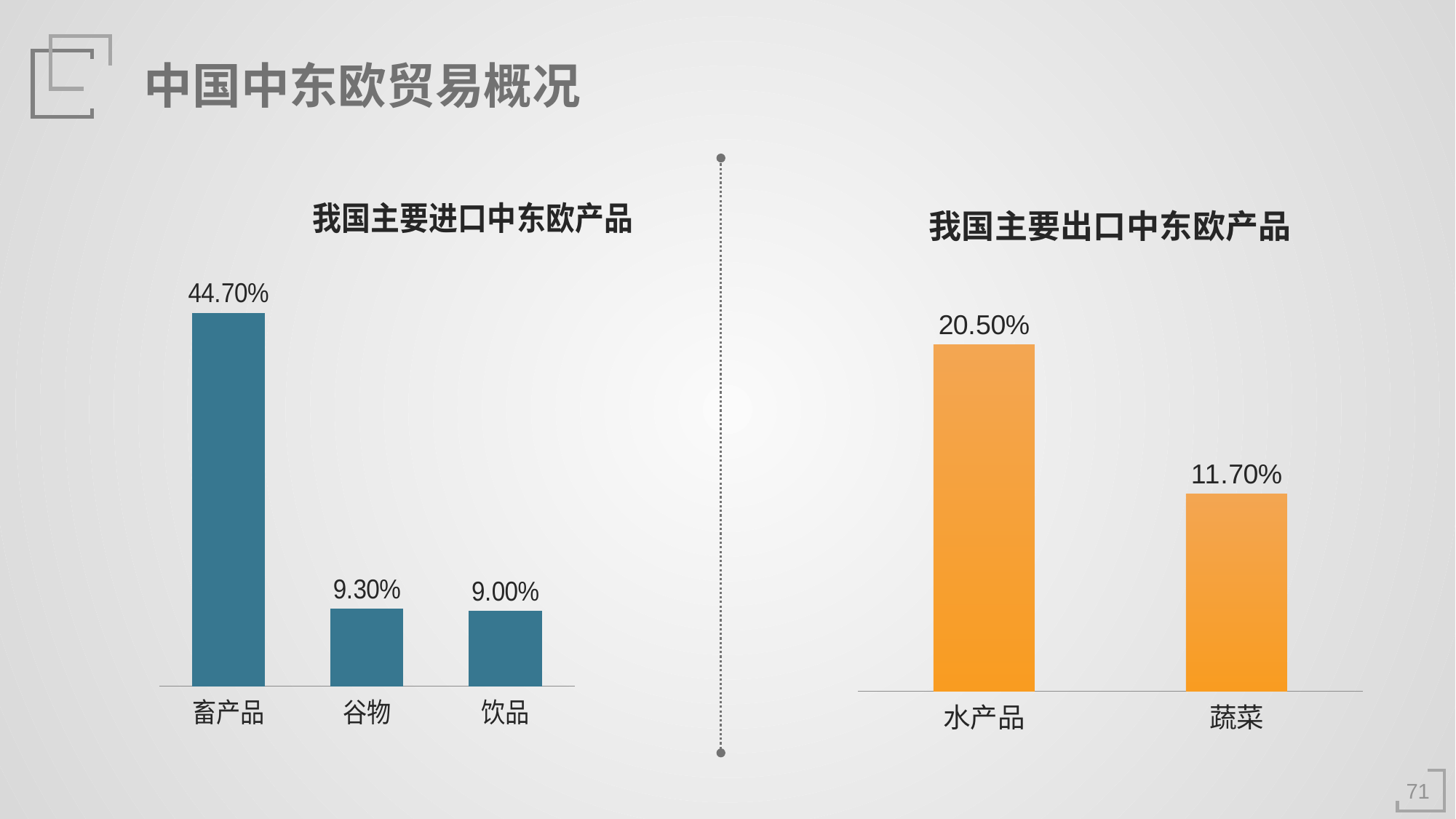
In the left chart (我国主要进口中东欧产品), which category has the highest value? 畜产品 How many categories are shown in the left chart (我国主要进口中东欧产品)? 3 In the left chart (我国主要进口中东欧产品), what is the value for 畜产品? 44.70% In the left chart (我国主要进口中东欧产品), what is the value for 谷物? 9.30% In the right chart (我国主要出口中东欧产品), what is the value for 蔬菜? 11.70% How many categories are shown in the right chart (我国主要出口中东欧产品)? 2 In the right chart (我国主要出口中东欧产品), which category has the higher value? 水产品 In the left chart (我国主要进口中东欧产品), which category has the lowest value? 饮品 In the right chart (我国主要出口中东欧产品), what is the difference between the values for 水产品 and 蔬菜? 8.80% In the right chart (我国主要出口中东欧产品), what is the value for 水产品? 20.50% In the left chart (我国主要进口中东欧产品), what is the difference between the values for 畜产品 and 谷物? 35.40% What type of chart is the right chart (我国主要出口中东欧产品)? Bar chart